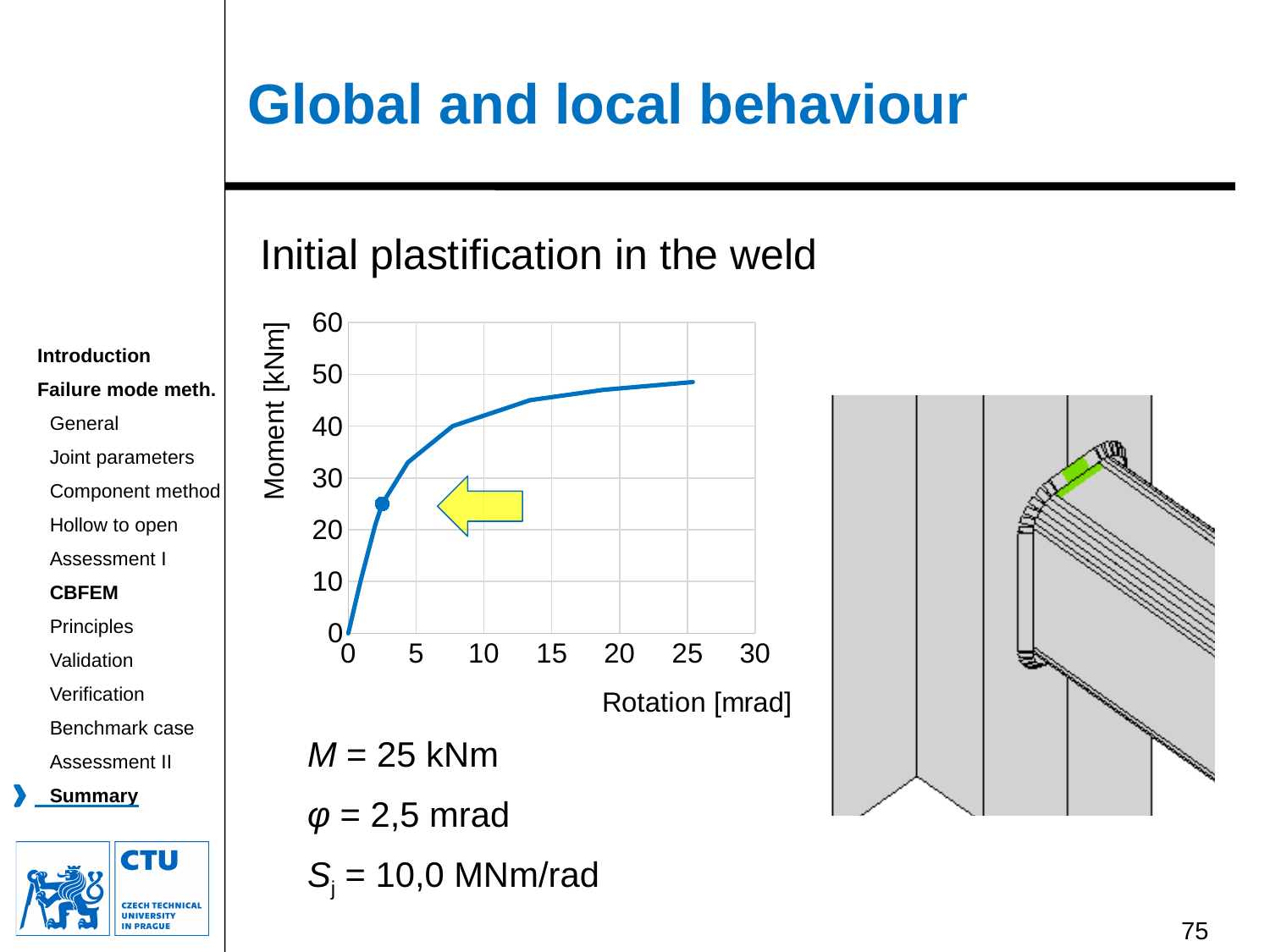
Is the moment at a rotation of 25 mrad greater or less than 40? greater How many curves are plotted on the chart? 1 Is the highest moment reached by the curve greater or less than 50? less What kind of chart is shown on the slide? line chart What is the moment at the marked point on the curve (initial plastification in the weld)? 25 kNm What is the rotation at the marked point on the curve? 2,5 mrad Is the moment at a rotation of 15 mrad greater or less than 40? greater What is the highest value shown on the vertical axis of the chart? 60 What is the label of the vertical axis of the chart? Moment [kNm] What is the label of the horizontal axis of the chart? Rotation [mrad] Does the moment rise or fall as the rotation increases along the x axis? rise